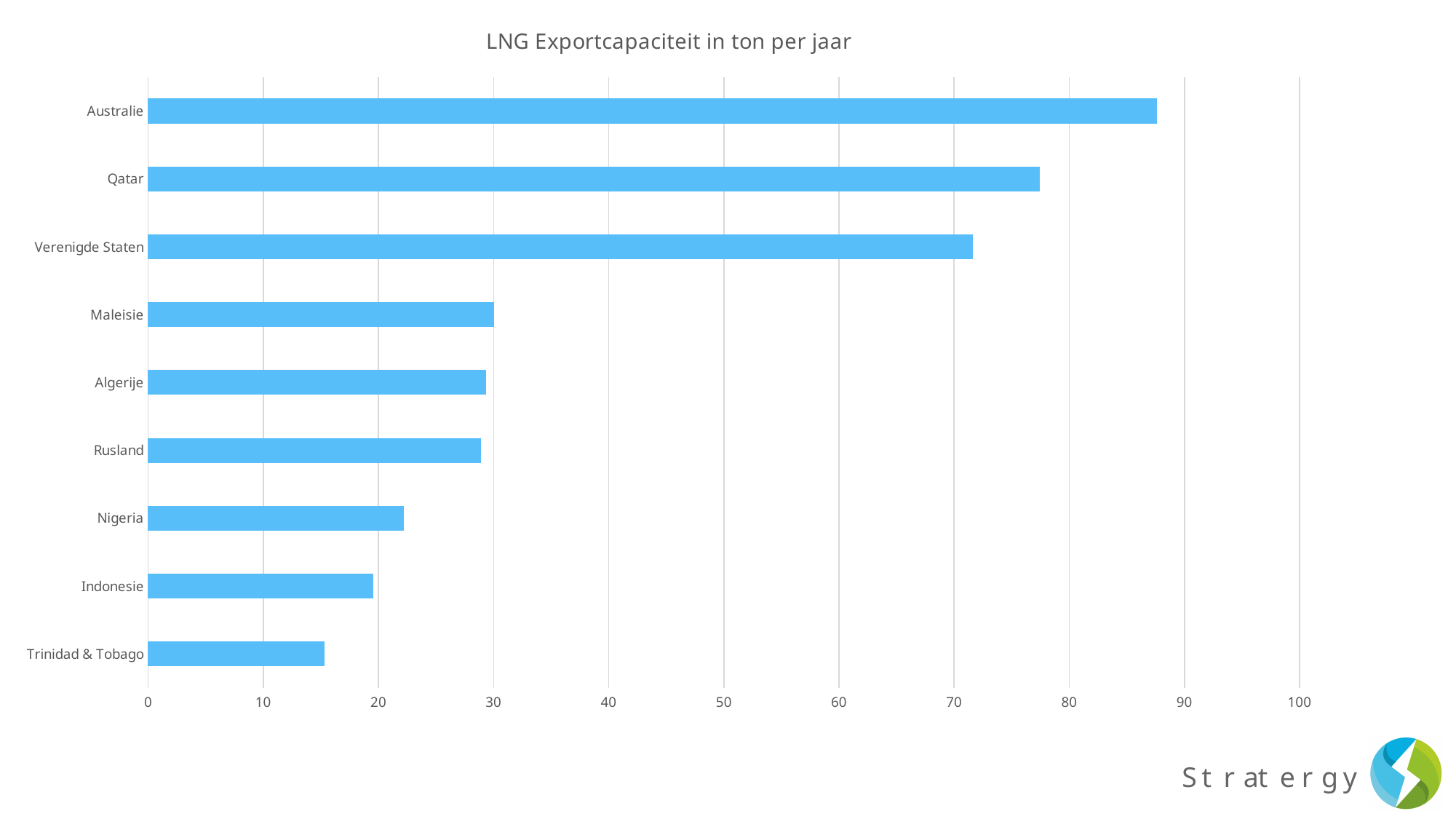
Is the value for Qatar greater or less than 80? less Which has a larger LNG export capacity, Qatar or Verenigde Staten? Qatar Is the value for Australie greater or less than 80? greater What is the title of the chart? LNG Exportcapaciteit in ton per jaar Which country has the highest LNG export capacity? Australie How many countries are shown in the chart? 9 Is the value for Rusland greater or less than 30? less Which has a larger LNG export capacity, Nigeria or Indonesie? Nigeria What kind of chart is shown on the slide? bar chart Which country has the lowest LNG export capacity? Trinidad & Tobago